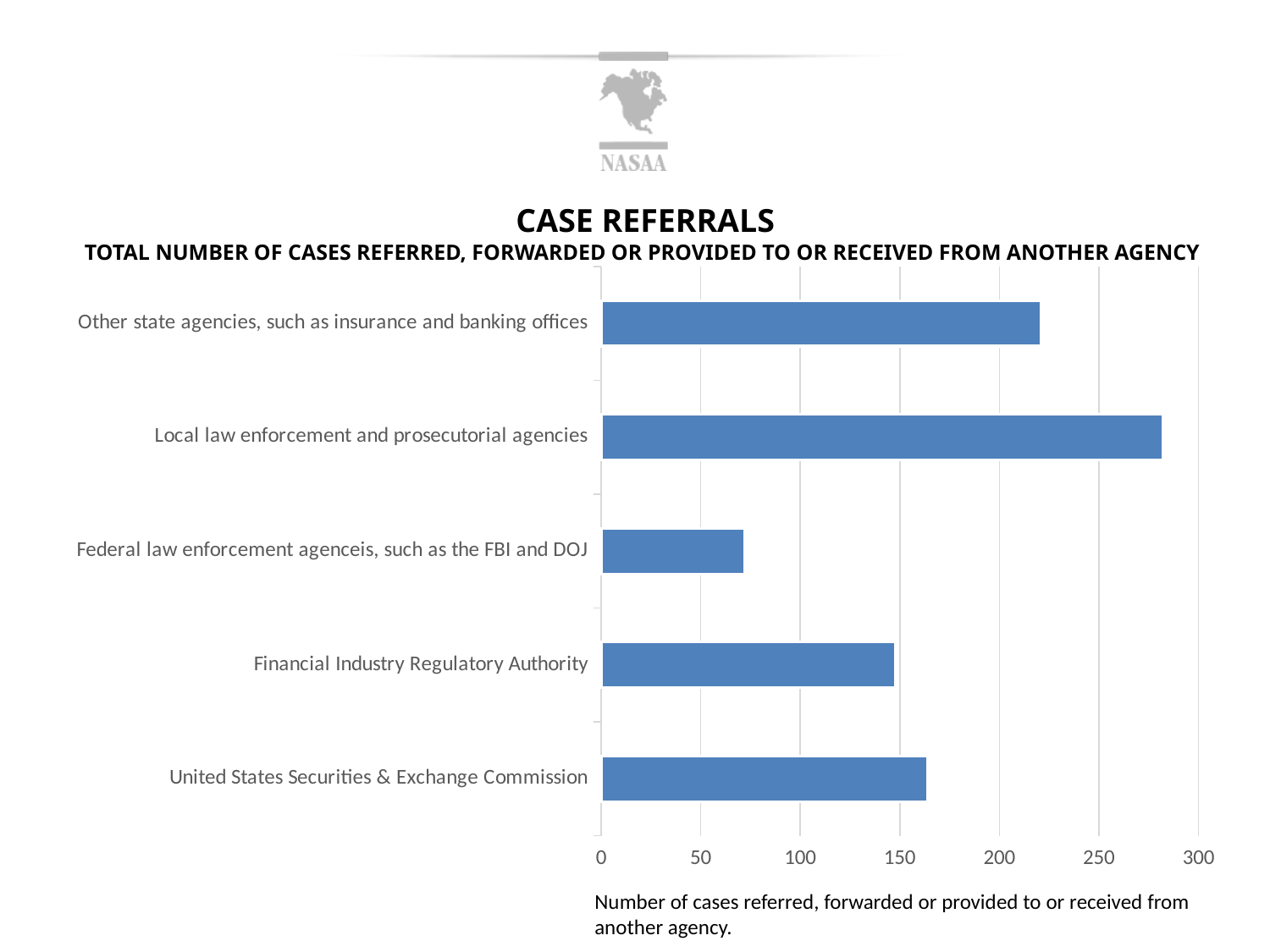
What is the title of the chart? CASE REFERRALS Which category has the highest number of case referrals? Local law enforcement and prosecutorial agencies Is the value for Other state agencies, such as insurance and banking offices greater or less than 200? greater Which category has the lowest number of case referrals? Federal law enforcement agenceis, such as the FBI and DOJ What kind of chart is shown on the slide? bar chart Which is larger: the value for Other state agencies, such as insurance and banking offices or the value for Federal law enforcement agenceis, such as the FBI and DOJ? Other state agencies, such as insurance and banking offices Which is larger: the value for United States Securities & Exchange Commission or the value for Financial Industry Regulatory Authority? United States Securities & Exchange Commission How many categories are plotted in the chart? 5 Is the value for Federal law enforcement agenceis, such as the FBI and DOJ greater or less than 100? less Is the value for United States Securities & Exchange Commission greater or less than 150? greater